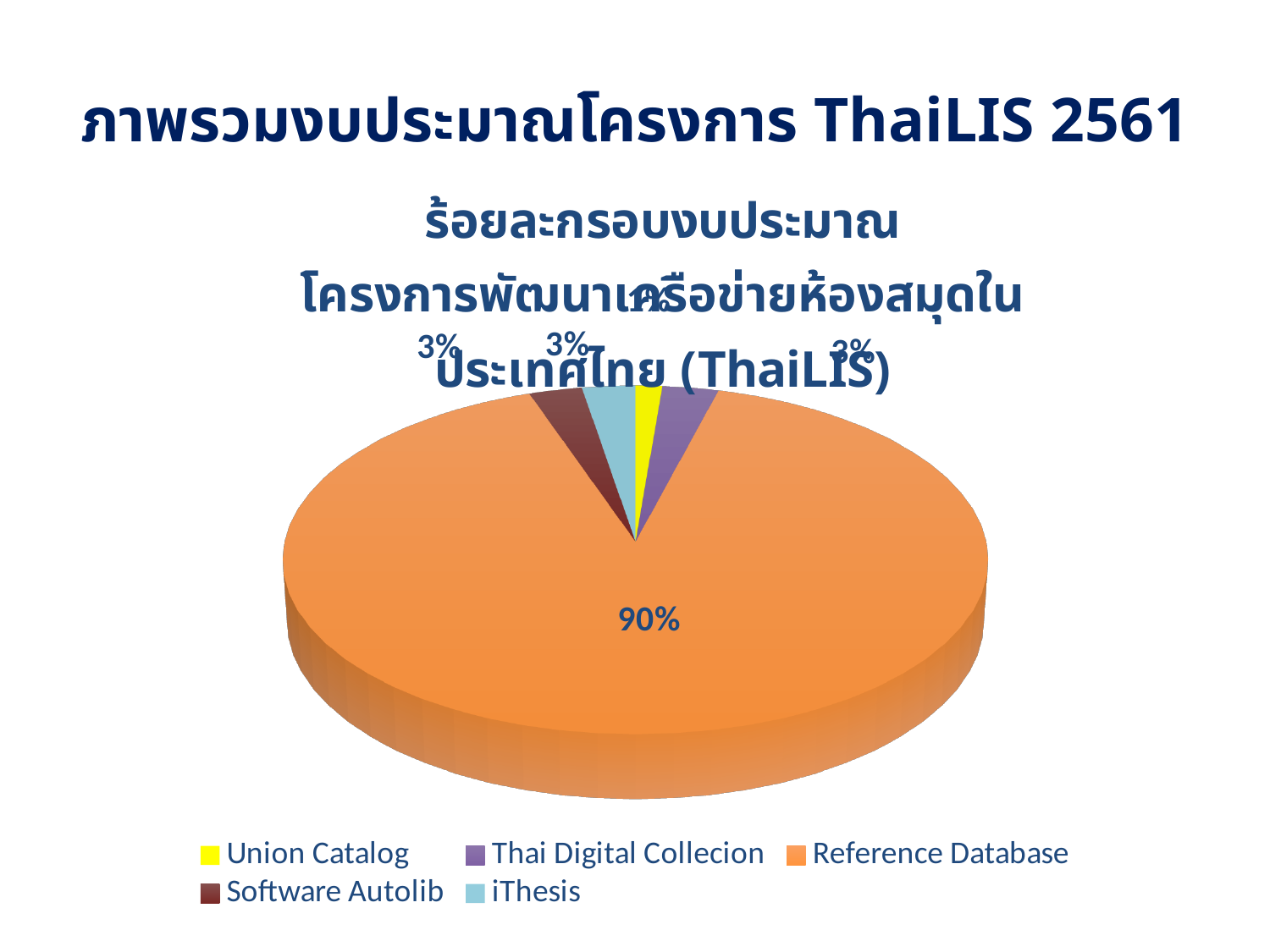
How many categories does the legend list? 5 What share of the pie does Reference Database represent? 90% How many slices does the pie chart have? 5 Which is larger, the slice for Reference Database or the slice for Software Autolib? Reference Database Which category has the largest slice of the pie? Reference Database What colour represents Reference Database in the legend? orange What percentage is shown for Software Autolib? 3% What kind of chart is shown on the slide? pie chart What colour represents Union Catalog in the legend? yellow Which is larger, the slice for Reference Database or the slice for iThesis? Reference Database What percentage of the budget does Reference Database account for? 90% What percentage is shown for iThesis? 3%